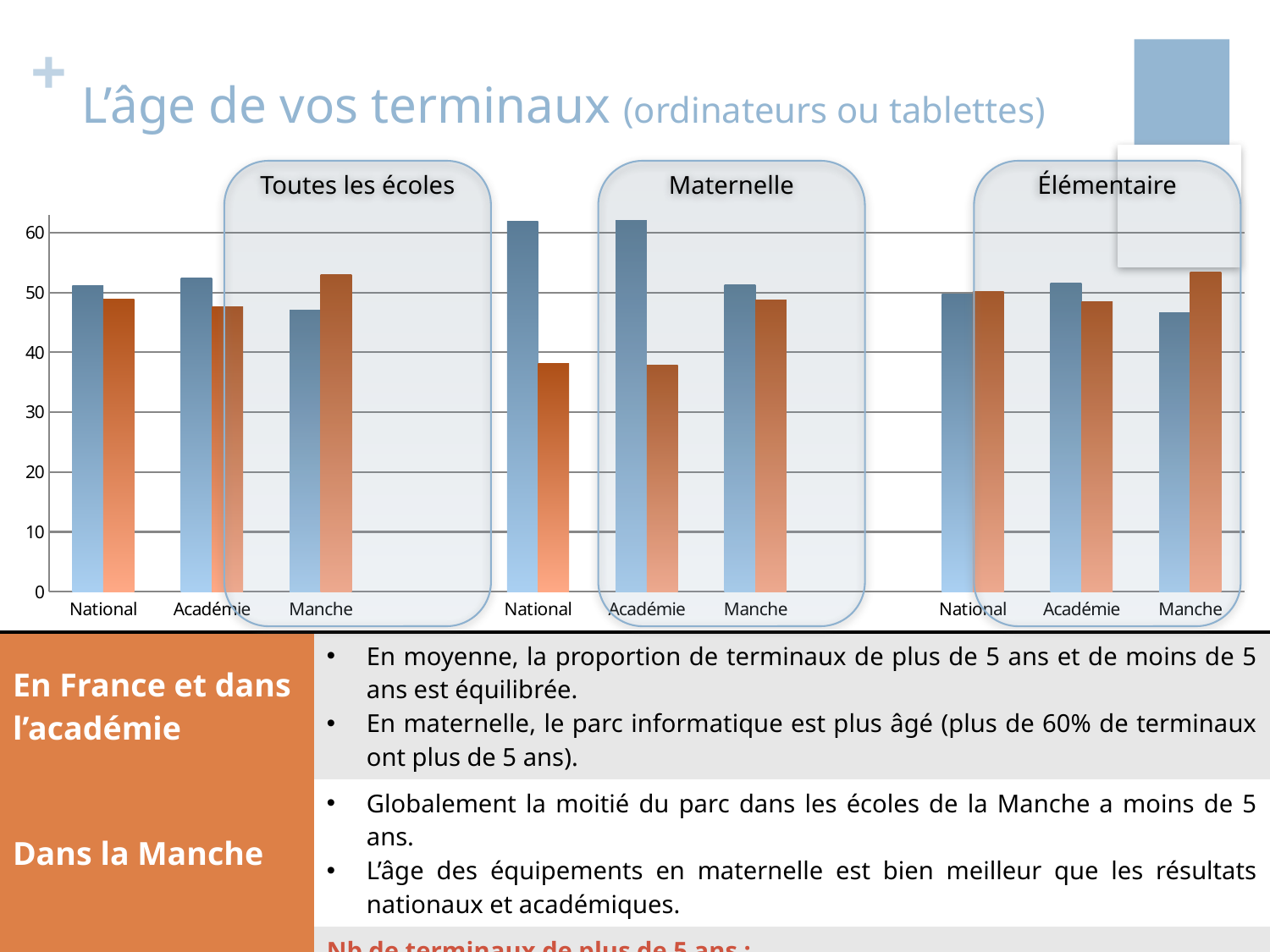
In the Élémentaire group, is the blue bar for Manche greater or less than 50? less How many bars are plotted for each category on the x axis? 2 In the Toutes les écoles group, which category has the highest orange bar? Manche In the Maternelle group, is the blue bar for National greater or less than 50? greater In the Maternelle group, is the orange bar for National greater or less than 40? less What is the title of the chart on the slide? L'âge de vos terminaux (ordinateurs ou tablettes) What kind of chart is shown on the slide? bar chart In the Maternelle group, which is larger for Académie, the blue bar or the orange bar? the blue bar What are the three group labels shown above the chart? Toutes les écoles, Maternelle, Élémentaire In the Maternelle group, which category has the lowest blue bar? Manche How many category labels appear along the x axis of the chart? 9